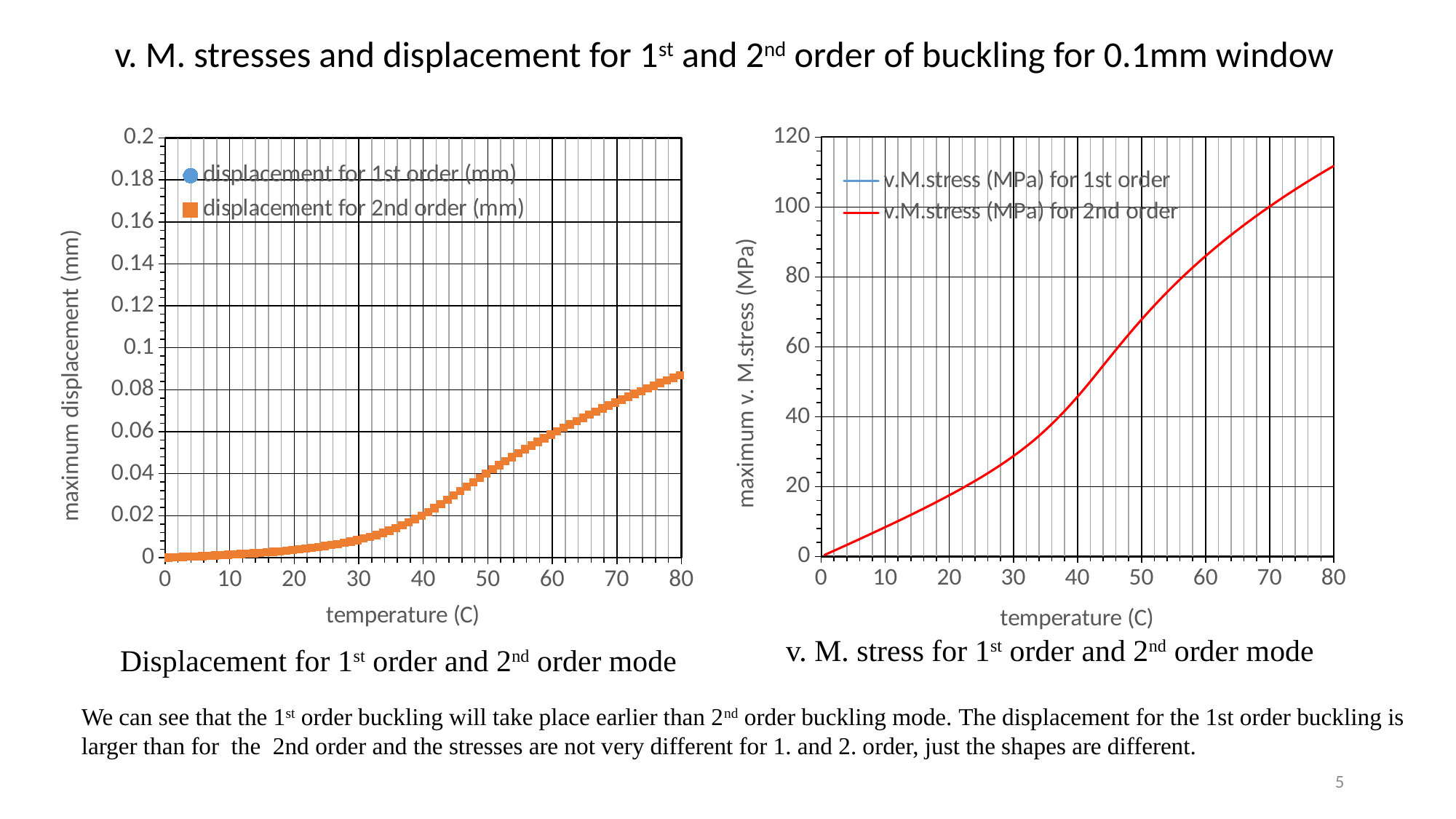
What kind of chart is the right chart (v. M. stress)? line chart On the right chart, is the v.M. stress at 20 C greater or less than 20 MPa? less On the left chart, do the displacement values rise or fall as temperature increases? rise On the right chart, do the v.M. stress values rise or fall as temperature increases? rise On the right chart, is the v.M. stress at 80 C greater or less than 100 MPa? greater On the left chart, is the displacement at 80 C greater or less than 0.08 mm? greater What kind of chart is the left chart (displacement)? scatter chart On the left chart, how many series does the legend list? 2 What is the x-axis title of the left chart? temperature (C) On the right chart, how many series does the legend list? 2